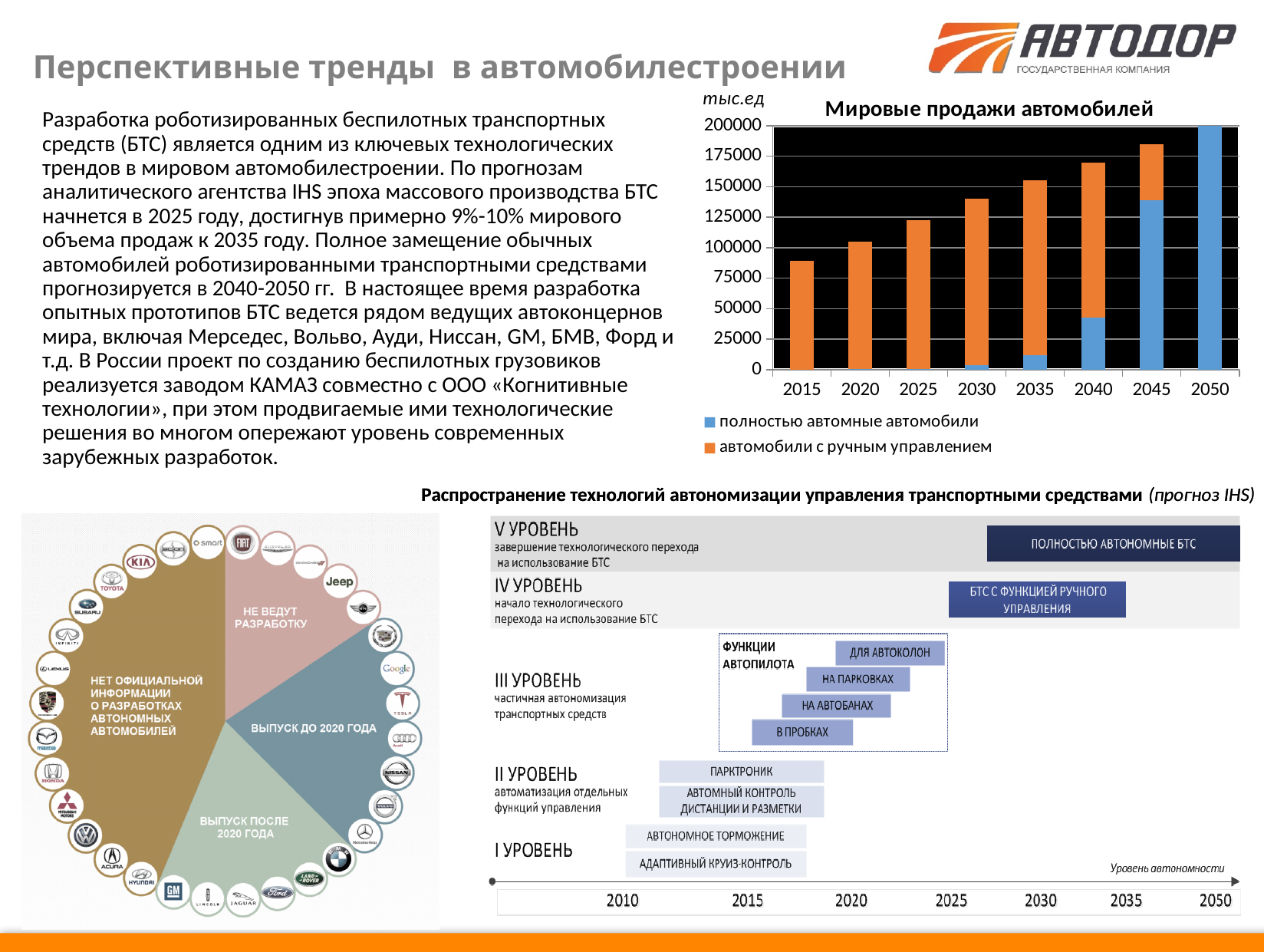
What kind of chart is "Мировые продажи автомобилей"? bar chart How many years are shown on the x axis of the "Мировые продажи автомобилей" chart? 8 In the "Мировые продажи автомобилей" chart, is the "полностью автомные автомобили" value for 2040 greater or less than 50000? less In the "Мировые продажи автомобилей" chart, is the total value for 2045 greater or less than 175000? greater In the "Мировые продажи автомобилей" chart, do the total bar heights rise or fall from 2015 to 2050? rise In the "Мировые продажи автомобилей" chart, which year has the larger total bar, 2020 or 2040? 2040 In the "Мировые продажи автомобилей" chart, which year has the lowest total bar? 2015 In the "Мировые продажи автомобилей" chart, which year has the highest total bar? 2050 In the "Мировые продажи автомобилей" chart, is the total value for 2015 greater or less than 100000? less How many series does the legend of the "Мировые продажи автомобилей" chart list? 2 What unit label is printed above the y axis of the "Мировые продажи автомобилей" chart? тыс.ед Which series in the "Мировые продажи автомобилей" chart is shown in orange? автомобили с ручным управлением